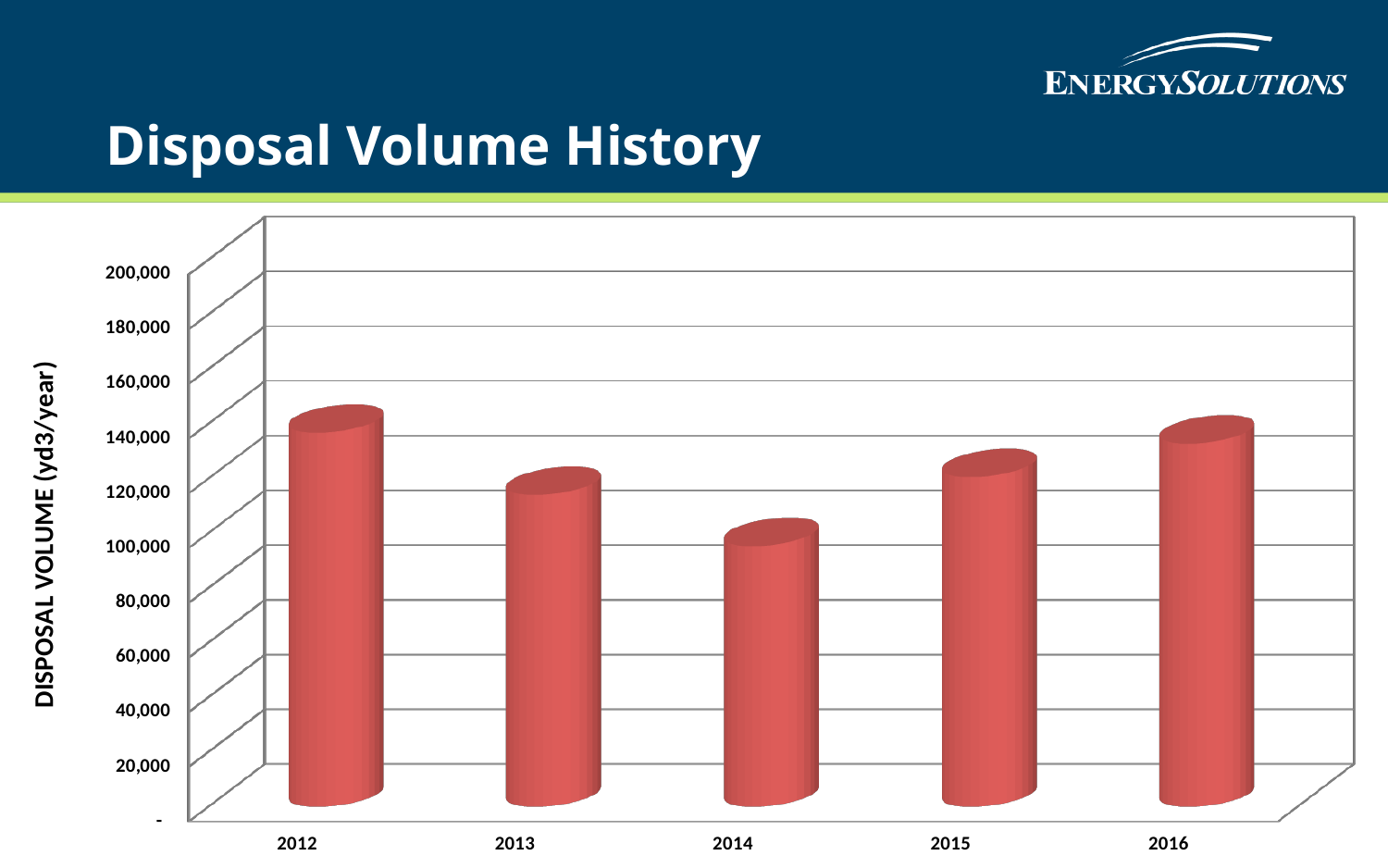
Is the disposal volume for 2013 greater or less than 100,000? greater How many years are shown on the x axis? 5 Is the disposal volume for 2015 greater or less than 140,000? less Is the disposal volume for 2014 greater or less than 80,000? greater What kind of chart is shown on the slide? bar chart Which year has the lowest disposal volume? 2014 What is the label on the vertical axis? DISPOSAL VOLUME (yd3/year) Which year has the larger disposal volume, 2012 or 2014? 2012 What is the title of the chart? Disposal Volume History Does the disposal volume rise or fall from 2012 to 2014? fall